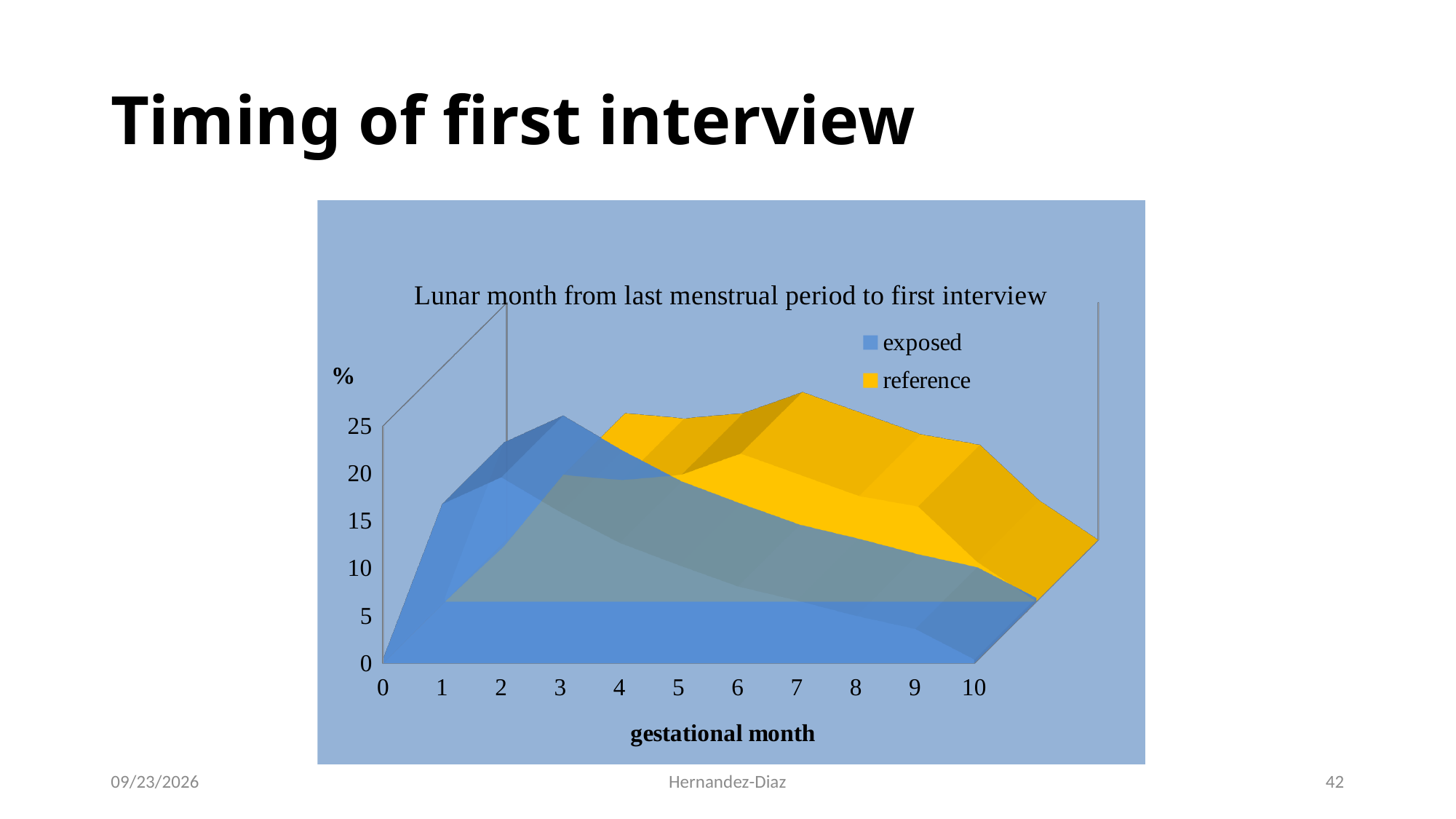
How many gestational month points are shown on the x axis? 11 At gestational month 3, which series has the larger value, exposed or reference? exposed Does the exposed series rise or fall from gestational month 0 to month 3? rise Does the reference series rise or fall from gestational month 7 to month 10? fall Does the exposed series rise or fall from gestational month 3 to month 10? fall What is the title of the chart? Lunar month from last menstrual period to first interview How many series does the legend list? 2 At which gestational month does the exposed series reach its highest value? 2 At which gestational month does the reference series reach its highest value? 5 Which series is shown in yellow? reference At gestational month 8, which series has the larger value, exposed or reference? reference What kind of chart is shown on the slide? area chart